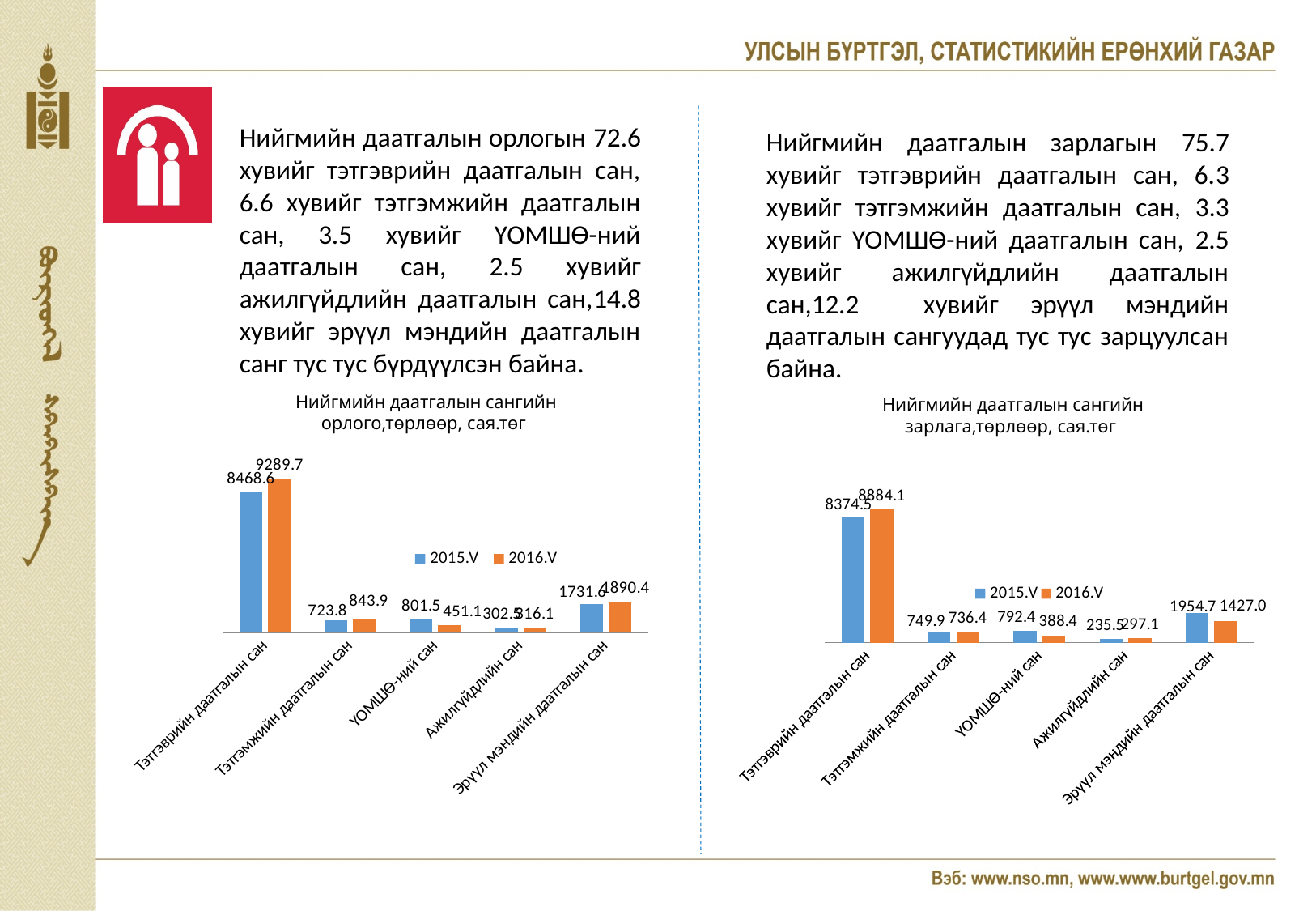
In the right chart (Нийгмийн даатгалын сангийн зарлага), what is the 2016.V value for Тэтгэврийн даатгалын сан? 8884.1 In the left chart (Нийгмийн даатгалын сангийн орлого), which category has the highest 2015.V value? Тэтгэврийн даатгалын сан In the left chart (Нийгмийн даатгалын сангийн орлого), what is the 2016.V value for Тэтгэврийн даатгалын сан? 9289.7 In the left chart (Нийгмийн даатгалын сангийн орлого), what is the 2015.V value for ҮОМШӨ-ний сан? 801.5 In the left chart (Нийгмийн даатгалын сангийн орлого), what is the 2016.V value for Тэтгэмжийн даатгалын сан? 843.9 What kind of chart is the right chart (Нийгмийн даатгалын сангийн зарлага)? Bar chart In the right chart (Нийгмийн даатгалын сангийн зарлага), which is larger for Эрүүл мэндийн даатгалын сан: the 2015.V value or the 2016.V value? 2015.V In the right chart (Нийгмийн даатгалын сангийн зарлага), what is the 2016.V value for ҮОМШӨ-ний сан? 388.4 In the right chart (Нийгмийн даатгалын сангийн зарлага), what is the 2015.V value for Эрүүл мэндийн даатгалын сан? 1954.7 In the left chart (Нийгмийн даатгалын сангийн орлого), how many series does the legend list? 2 In the left chart (Нийгмийн даатгалын сангийн орлого), what is the difference between the 2016.V and 2015.V values for Тэтгэврийн даатгалын сан? 821.1 In the right chart (Нийгмийн даатгалын сангийн зарлага), how many categories are shown on the x axis? 5